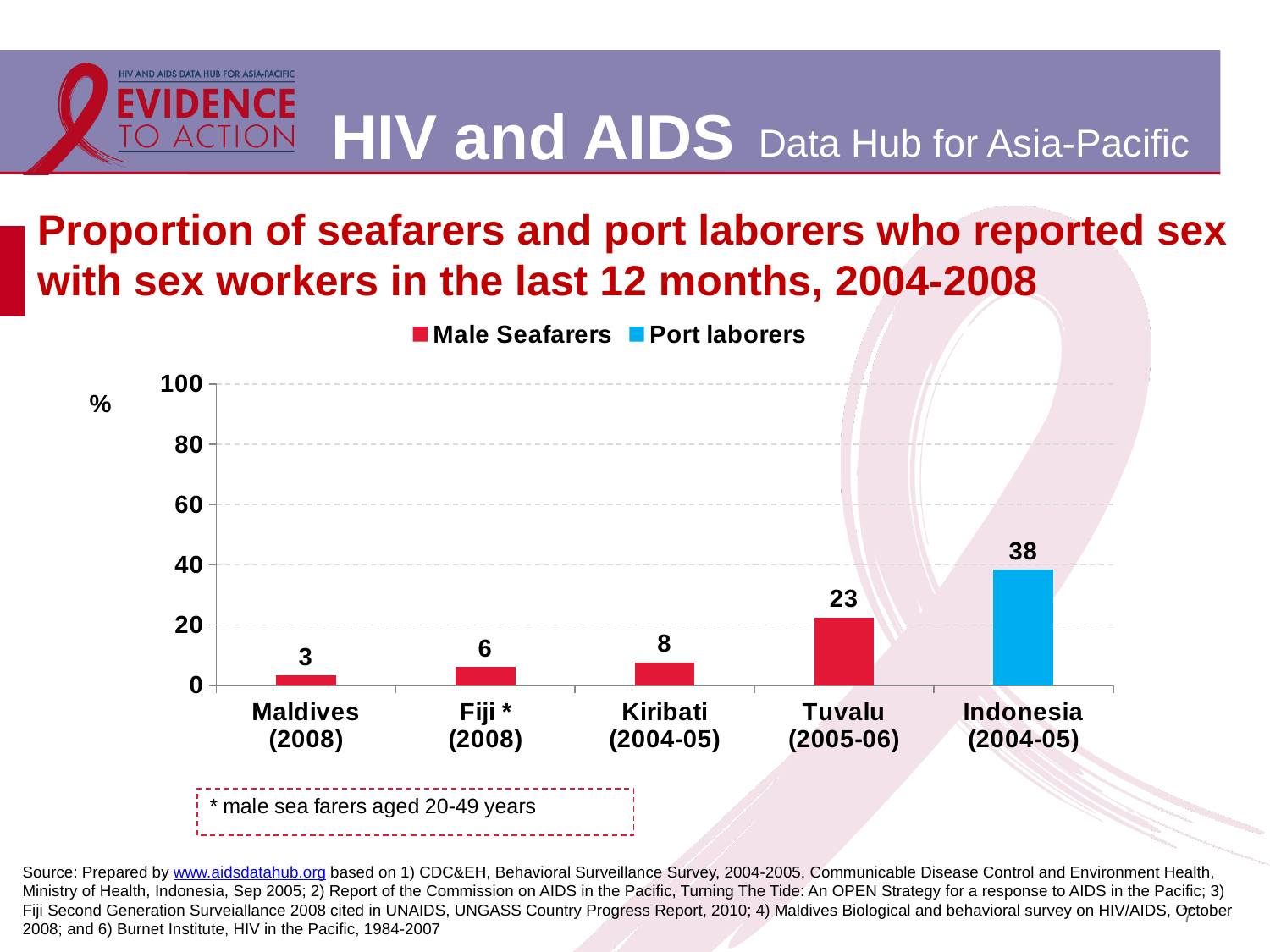
Which is larger, the value for Kiribati (2004-05) or Fiji * (2008)? Kiribati (2004-05) What is the value for Indonesia (2004-05)? 38 Which series does the Indonesia (2004-05) bar belong to? Port laborers How many series does the legend list? 2 What is the value for Tuvalu (2005-06)? 23 What is the value for Maldives (2008)? 3 What kind of chart is shown? bar chart What is the difference between the values for Indonesia (2004-05) and Tuvalu (2005-06)? 15 Is the value for Tuvalu (2005-06) greater or less than 20? greater Which country has the lowest value? Maldives (2008) How many countries are shown on the chart? 5 Which country has the highest value? Indonesia (2004-05)